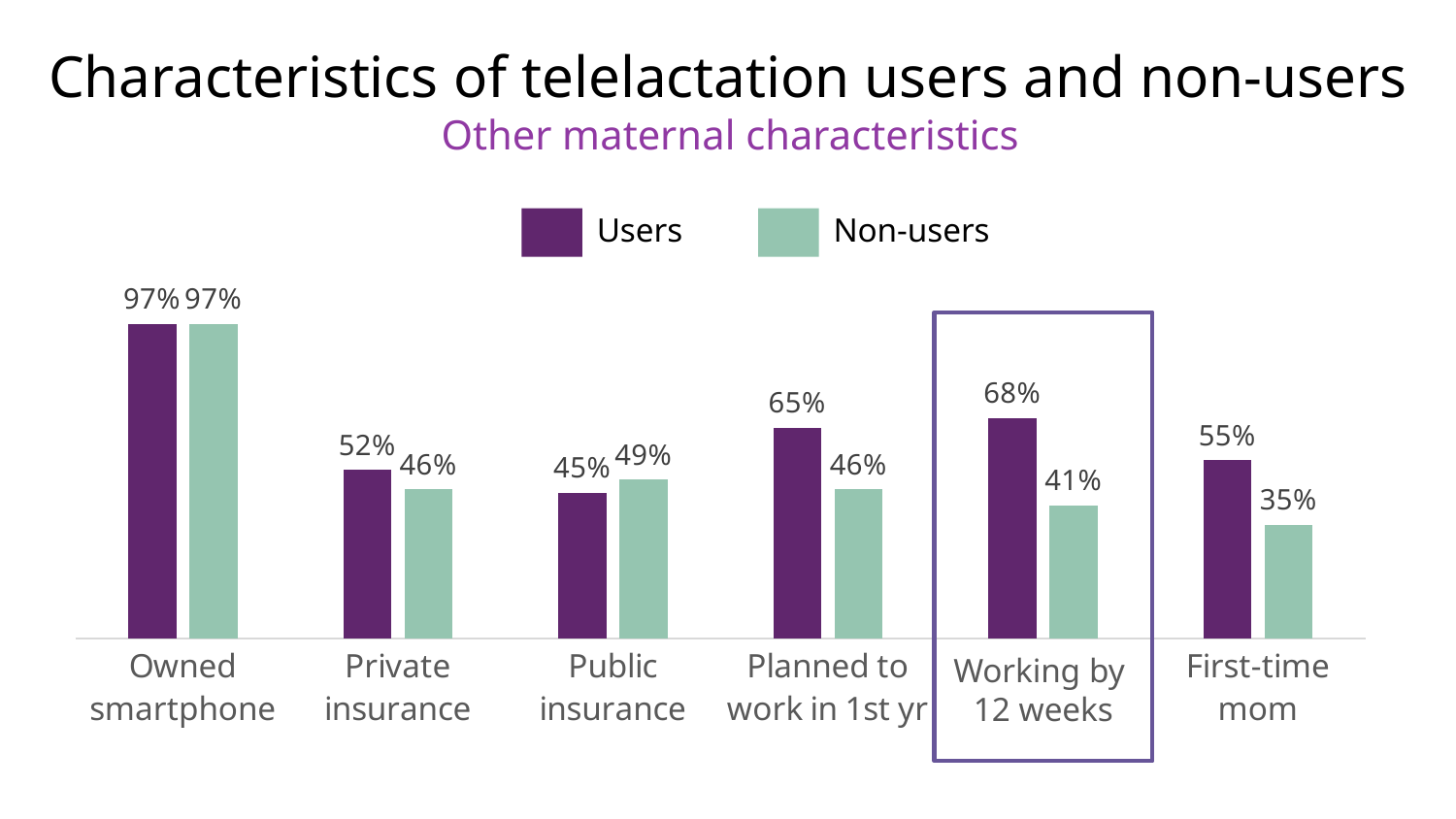
What is the difference between Users and Non-users for Working by 12 weeks? 27% Which category has the lowest value for Non-users? First-time mom What is the difference between Users and Non-users for Planned to work in 1st yr? 19% Which is larger for Public insurance, Users or Non-users? Non-users What percentage of Users owned a smartphone? 97% Which category has the highest value for Users? Owned smartphone What is the value for Non-users for Public insurance? 49% How many series does the legend list? 2 How many categories are shown on the x axis? 6 What percentage of Users were first-time moms? 55% What is the value for Non-users in the Working by 12 weeks category? 41% What kind of chart is shown on the slide? Bar chart